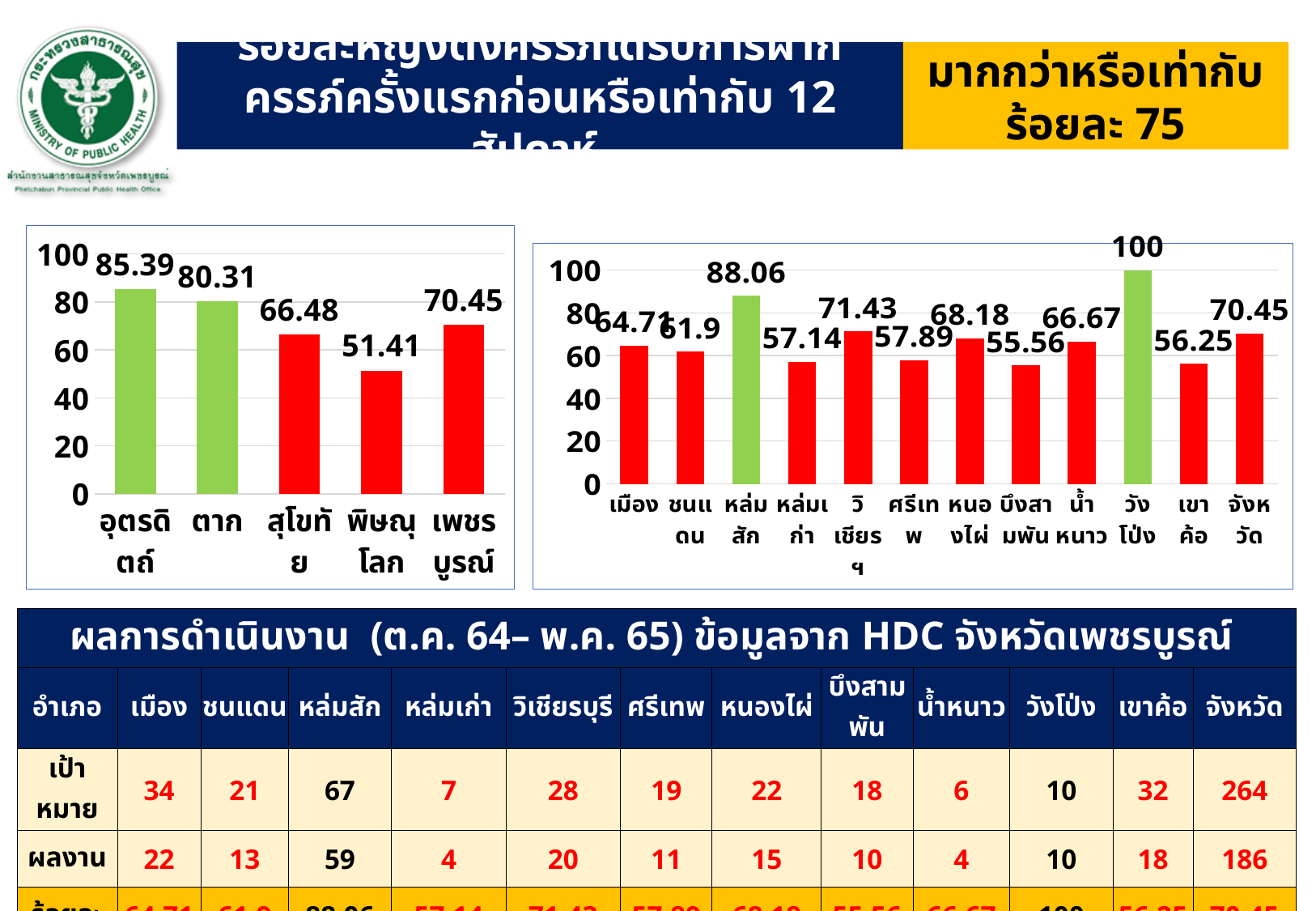
In the right chart, what is the value for หล่มสัก? 88.06 In the right chart, which category has the lowest value? บึงสามพัน In the left chart, how many bars are shown? 5 In the right chart, which is larger, the value for วิเชียรบุรี or the value for หนองไผ่? วิเชียรบุรี In the right chart, what is the difference between the values for วังโป่ง and เขาค้อ? 43.75 In the right chart, how many bars are shown? 12 In the right chart, which category has the highest value? วังโป่ง In the left chart, which category has the highest value? อุตรดิตถ์ What type of chart is the right chart? Bar chart In the left chart, what is the value for ตาก? 80.31 In the left chart, which category has the lowest value? พิษณุโลก In the left chart, what is the difference between the values for อุตรดิตถ์ and พิษณุโลก? 33.98